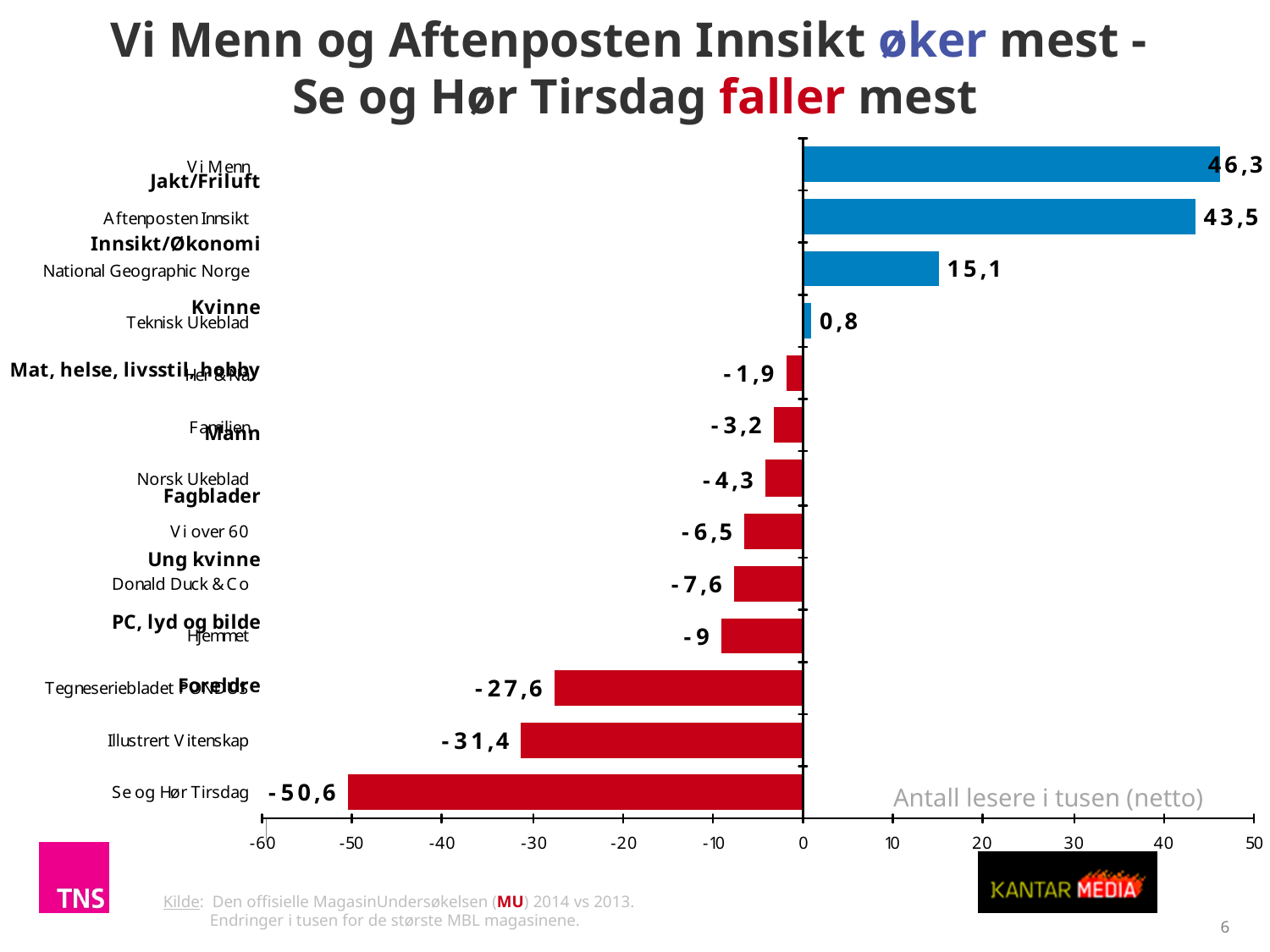
What is the value for Illustrert Vitenskap? -31,4 Which category has the lowest value? Se og Hør Tirsdag What is the value for National Geographic Norge? 15,1 What is the difference between the values for Vi Menn and Aftenposten Innsikt? 2,8 What colour are the bars with negative values? Red What is the value for Vi Menn? 46,3 What is the value for Se og Hør Tirsdag? -50,6 What kind of chart is shown on the slide? Bar chart What is the value for Aftenposten Innsikt? 43,5 Which has a larger value, Donald Duck & Co or Hjemmet? Donald Duck & Co How many bars are shown in the chart? 13 Which category has the highest value? Vi Menn